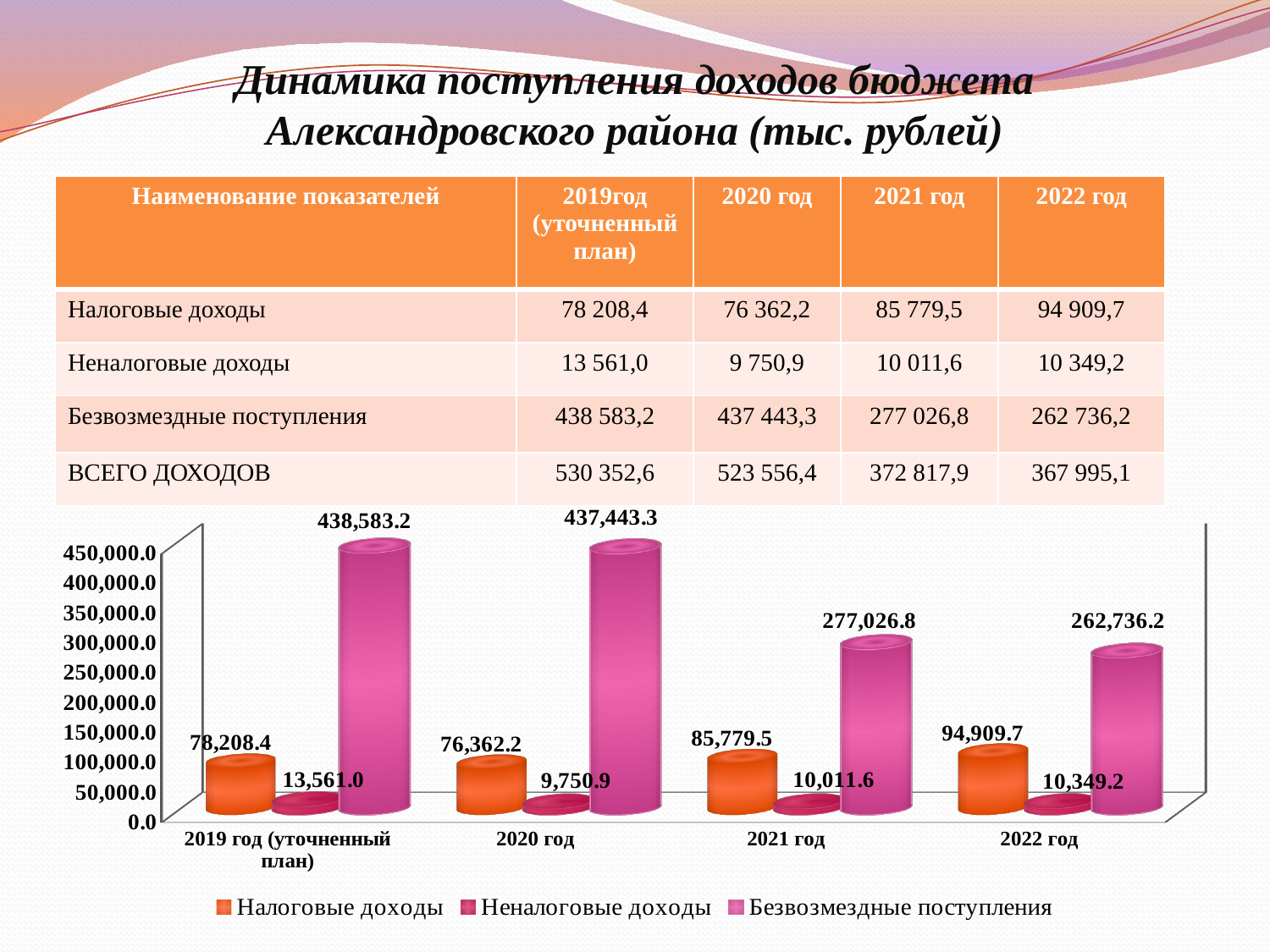
Which year has the larger value for Безвозмездные поступления, 2021 год or 2022 год? 2021 год What type of chart is shown on the slide? bar chart What is the value of Неналоговые доходы for 2020 год? 9,750.9 What is the value of Налоговые доходы for 2022 год? 94,909.7 Is the value of Налоговые доходы for 2019 год (уточненный план) greater or less than 100,000.0? less How many series does the chart legend list? 3 What is the value of Безвозмездные поступления for 2021 год? 277,026.8 By how much did Налоговые доходы increase from 2021 год to 2022 год? 9,130.2 How many year categories are shown on the x axis of the chart? 4 Do the values of Налоговые доходы rise or fall from 2020 год to 2022 год? rise In which year is Неналоговые доходы lowest? 2020 год In which year is Безвозмездные поступления highest? 2019 год (уточненный план)